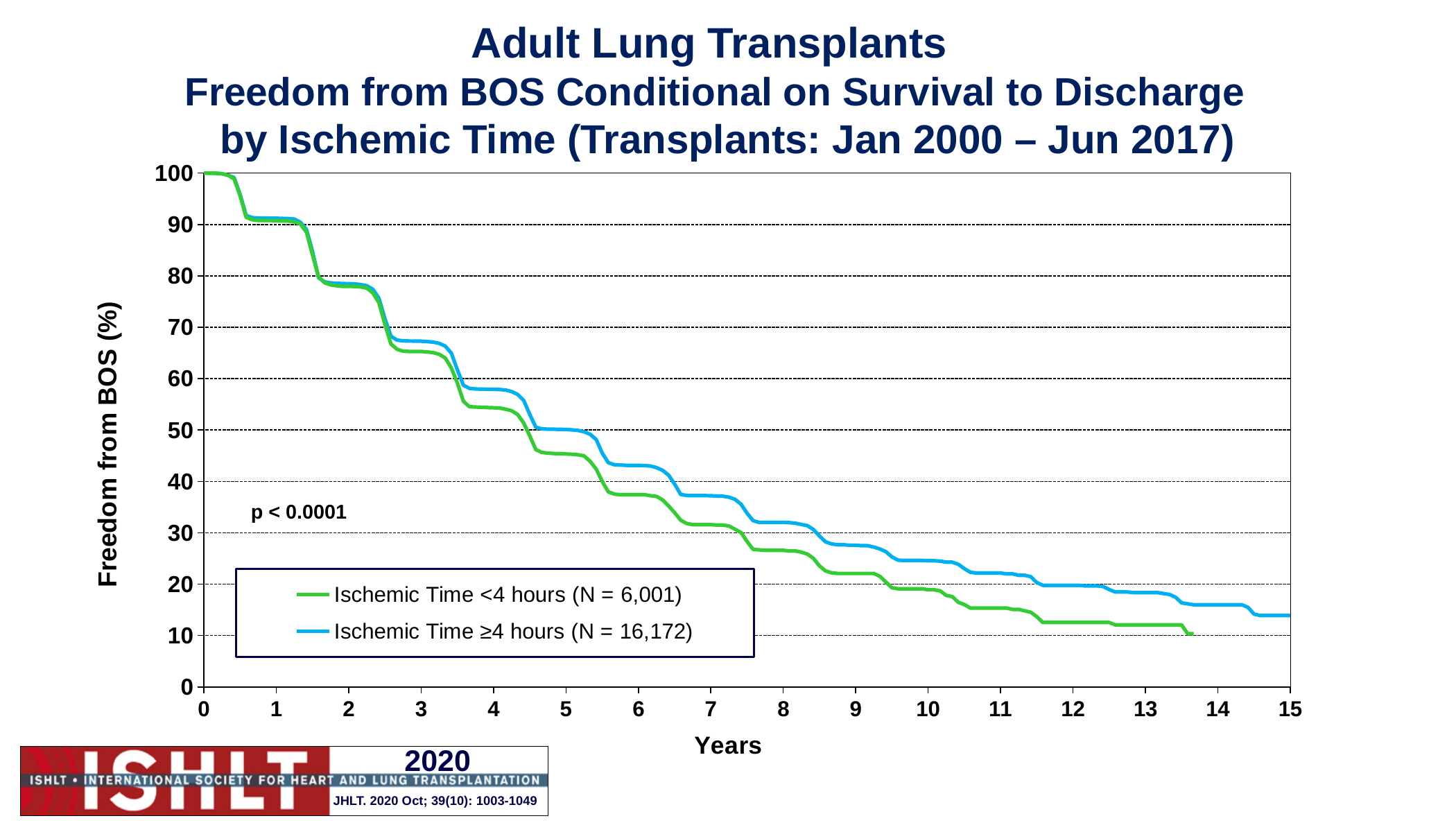
Is the value for Ischemic Time ≥4 hours at year 10 greater or less than 20? greater What is the N for the Ischemic Time ≥4 hours group shown in the legend? 16,172 What is the freedom from BOS value for both series at year 0? 100 Is the value for Ischemic Time ≥4 hours at year 15 greater or less than 20? less Is the value for Ischemic Time <4 hours at year 5 greater or less than 50? less What p-value is printed on the chart? p < 0.0001 At year 10, which series has the higher freedom from BOS: Ischemic Time <4 hours or Ischemic Time ≥4 hours? Ischemic Time ≥4 hours How many series does the legend list? 2 Do the values for Ischemic Time <4 hours rise or fall as years increase? Fall What kind of chart is shown on the slide? Line chart